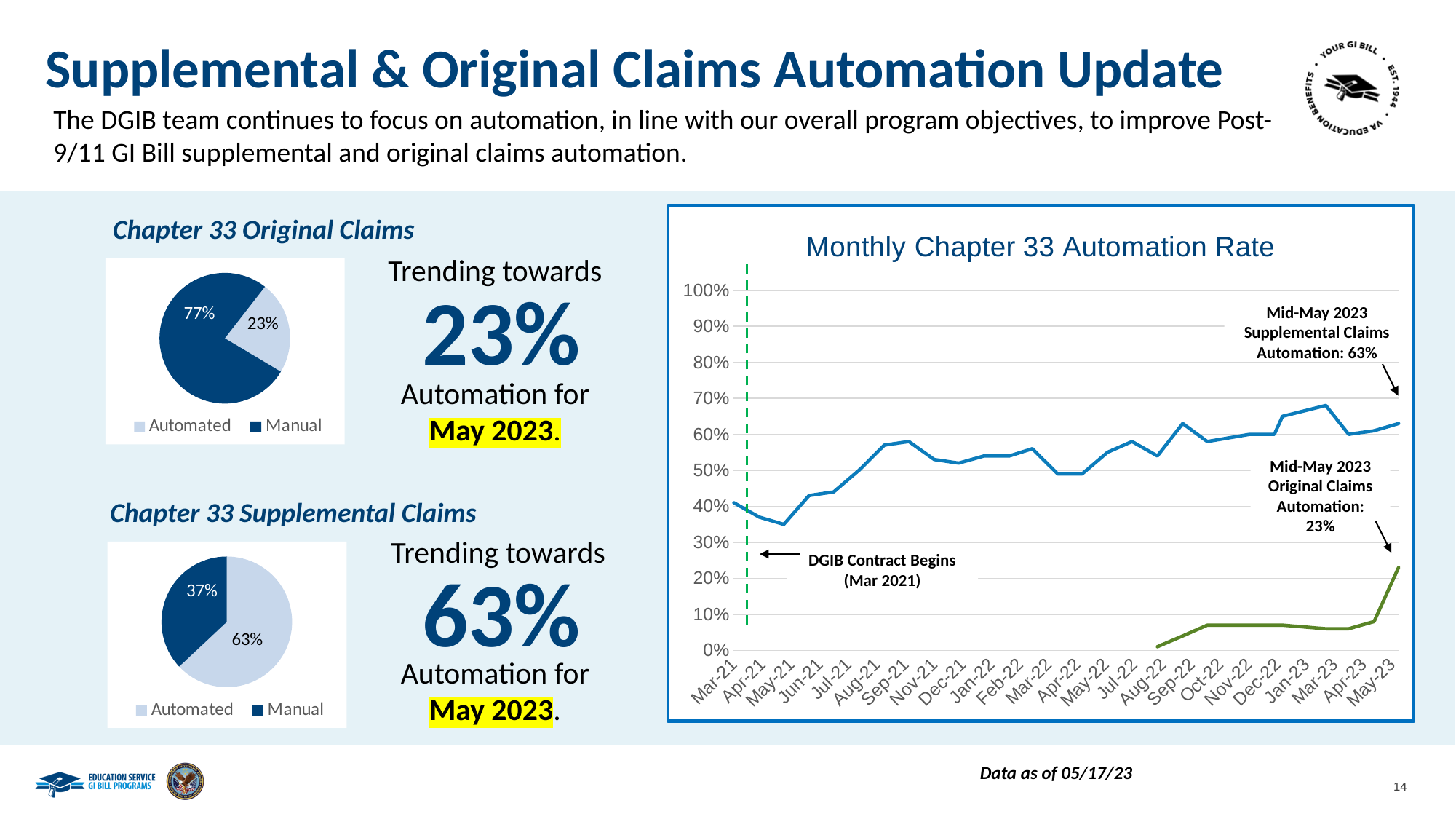
In the Chapter 33 Supplemental Claims pie chart, what share of claims is Manual? 37% In the Chapter 33 Original Claims pie chart, what share of claims is Manual? 77% What kind of chart is the Monthly Chapter 33 Automation Rate chart? Line chart In the Monthly Chapter 33 Automation Rate chart, is the supplemental claims value for May-21 greater or less than 40%? less What kind of chart is the Chapter 33 Original Claims chart? Pie chart In the Chapter 33 Supplemental Claims pie chart, which slice is larger, Automated or Manual? Automated In the Monthly Chapter 33 Automation Rate chart, what is the Mid-May 2023 Supplemental Claims automation rate? 63% In the Monthly Chapter 33 Automation Rate chart, is the supplemental claims value for Jan-23 greater or less than 60%? greater In the Chapter 33 Original Claims pie chart, what share of claims is Automated? 23% In the Monthly Chapter 33 Automation Rate chart, what is the Mid-May 2023 Original Claims automation rate? 23% In the Chapter 33 Original Claims pie chart, what is the difference between the Manual and Automated shares? 54% In the Chapter 33 Supplemental Claims pie chart, what share of claims is Automated? 63%